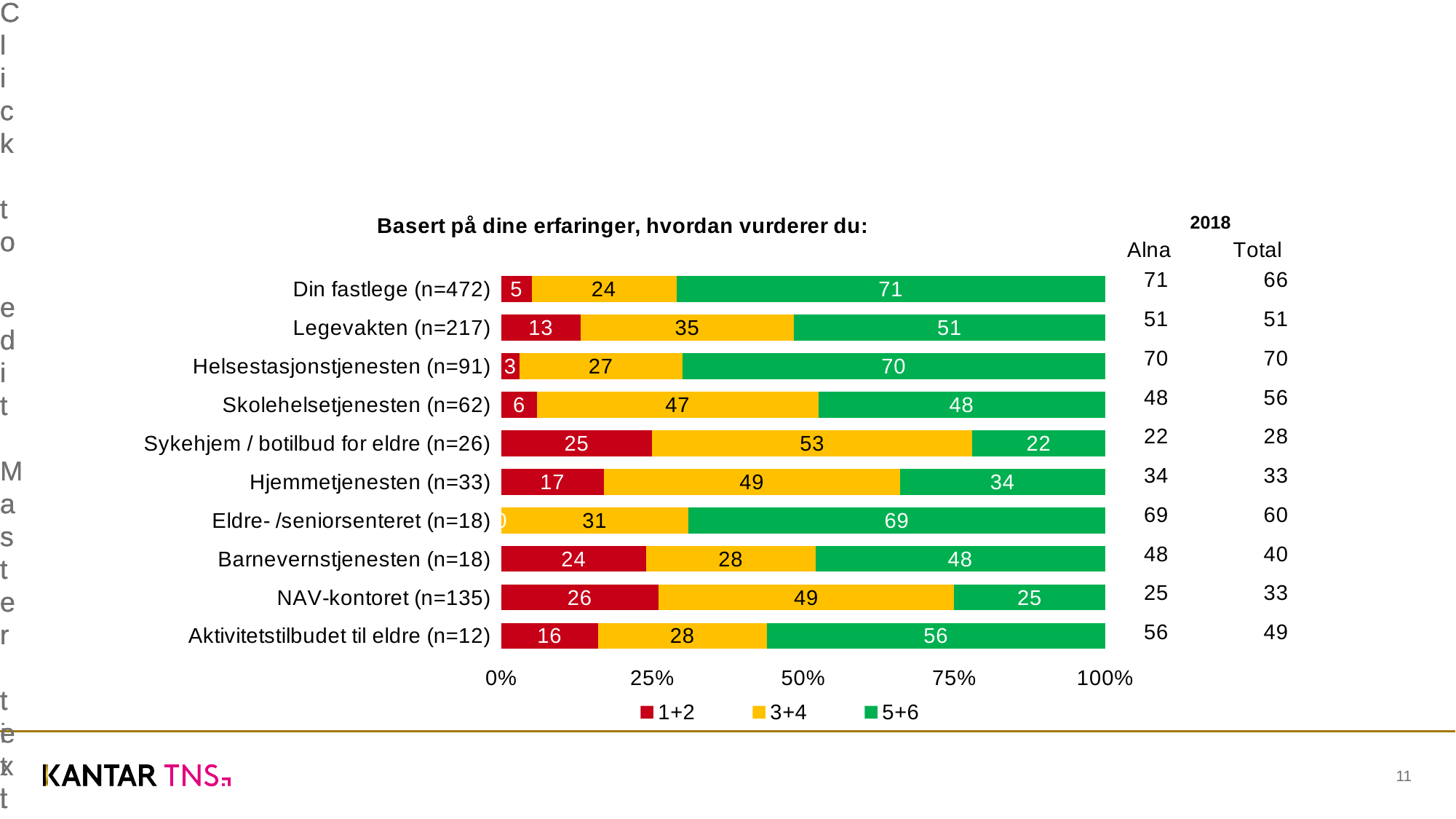
What is the value of the 1+2 series for NAV-kontoret (n=135)? 26 Which is larger: the 1+2 value for Barnevernstjenesten (n=18) or the 1+2 value for Hjemmetjenesten (n=33)? Barnevernstjenesten (n=18) What is the value of the 3+4 series for Sykehjem / botilbud for eldre (n=26)? 53 Which category has the lowest value for the 5+6 series? Sykehjem / botilbud for eldre (n=26) What is the total of the stacked bar for Skolehelsetjenesten (n=62)? 101 What is the title of the chart? Basert på dine erfaringer, hvordan vurderer du: What is the difference between the 5+6 values for Helsestasjonstjenesten (n=91) and Legevakten (n=217)? 19 What kind of chart is shown on the slide? Stacked bar chart How many categories are shown on the chart? 10 How many series does the legend list? 3 Which category has the highest value for the 5+6 series? Din fastlege (n=472) What is the value of the 5+6 series for Din fastlege (n=472)? 71